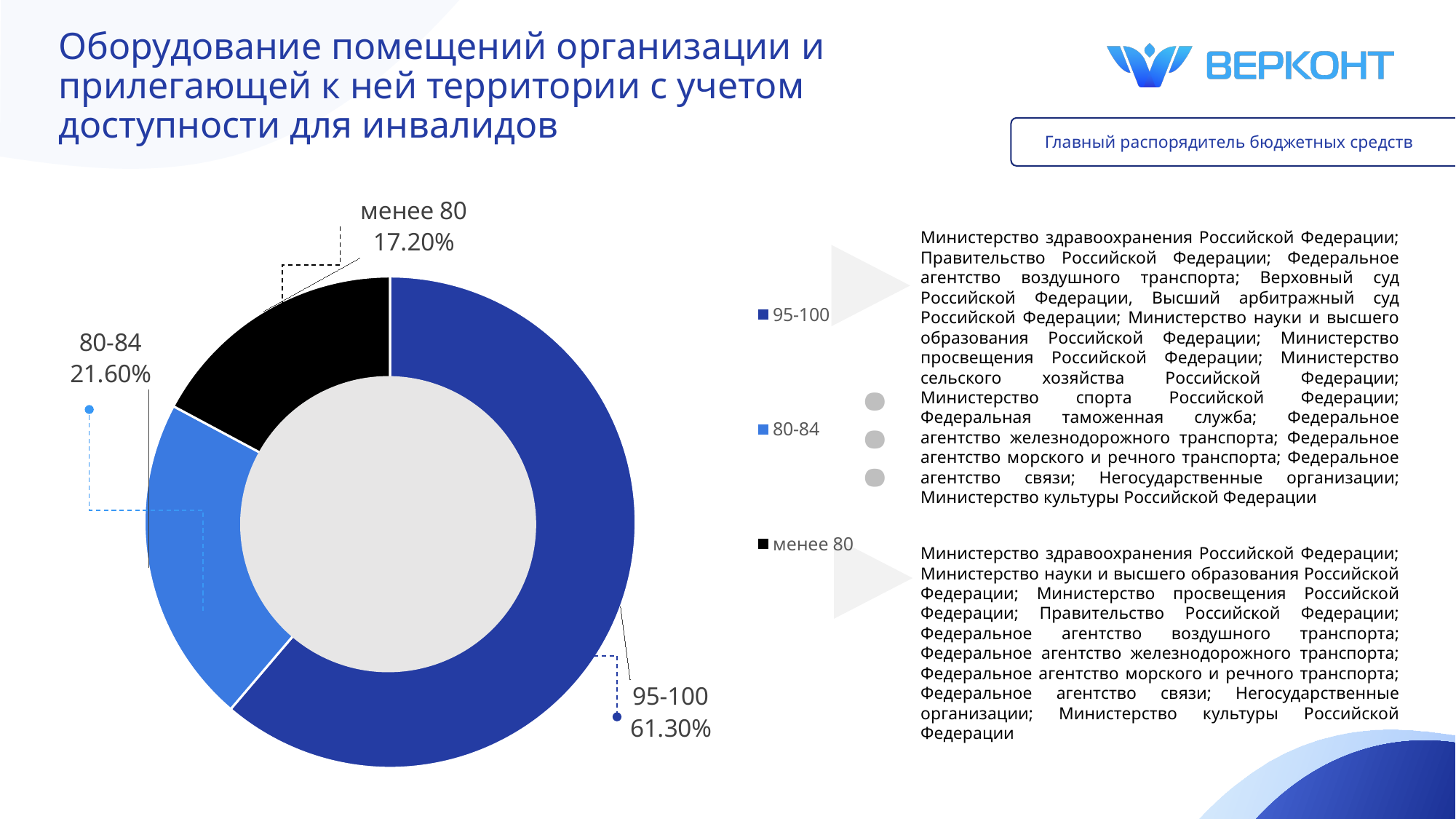
What is the difference in percentage points between the "80-84" and "менее 80" shares? 4.40 What share of the doughnut chart does the "менее 80" category hold? 17.20% Which category has the largest share in the doughnut chart? 95-100 What share of the doughnut chart does the "80-84" category hold? 21.60% What share of the doughnut chart does the "95-100" category hold? 61.30% Which share is larger: "80-84" or "менее 80"? 80-84 What colour represents the "менее 80" category in the chart? Black What is the difference in percentage points between the "95-100" and "80-84" shares? 39.70 What type of chart is shown on the slide? Doughnut (pie) chart Which category has the smallest share in the doughnut chart? менее 80 How many entries does the chart legend list? 3 How many categories are shown in the doughnut chart? 3